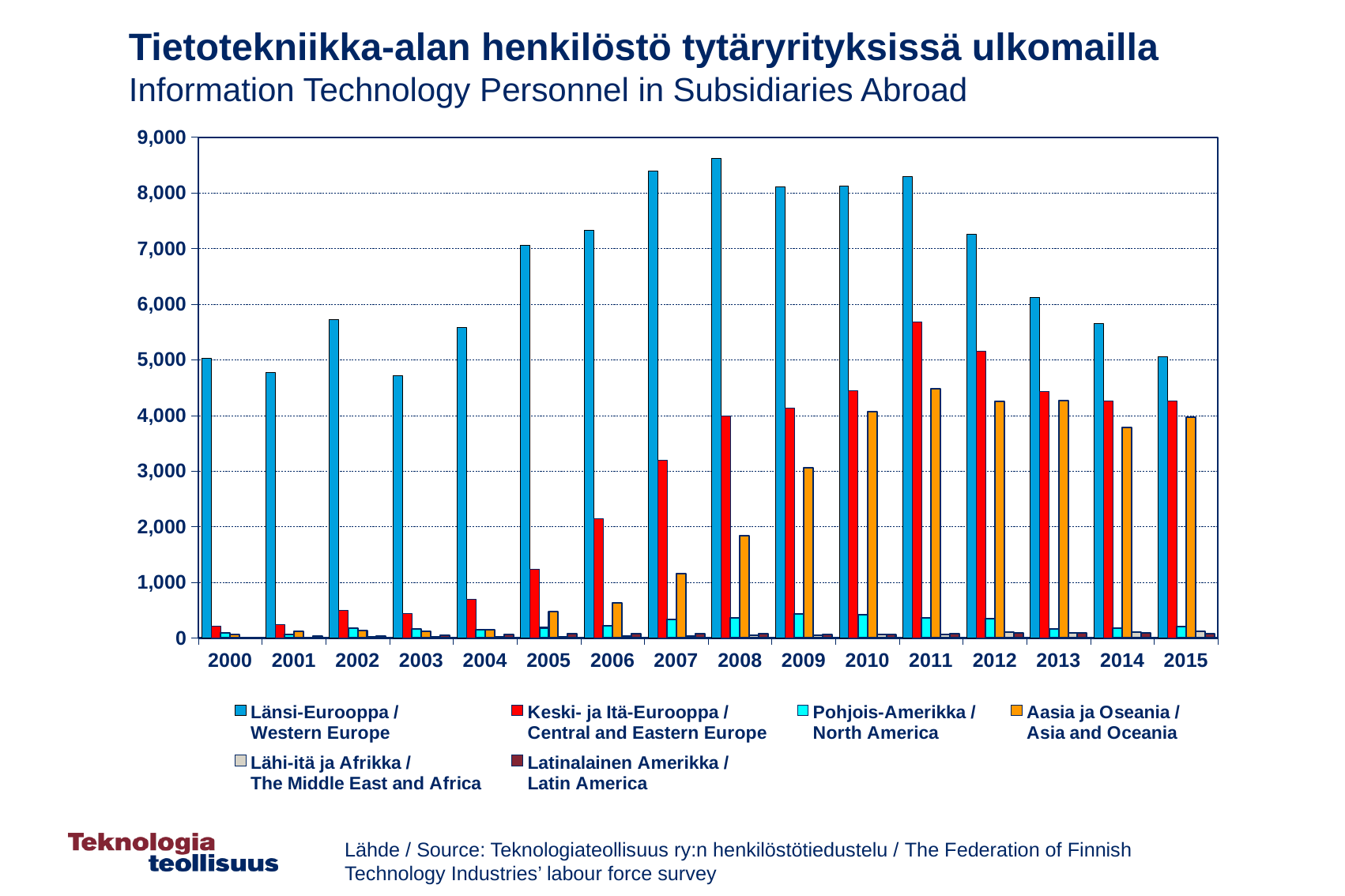
Is the value for Asia and Oceania in 2008 greater or less than 2,000? less What kind of chart is shown on the slide? bar chart Which colour represents Asia and Oceania in the chart? orange Is the value for Central and Eastern Europe in 2007 greater or less than 3,000? greater Is the value for Western Europe in 2008 greater or less than 8,000? greater In which year is the value for Central and Eastern Europe highest? 2011 How many series does the legend list? 6 How many years are shown on the x axis? 16 In 2009, which is larger: the value for Central and Eastern Europe or the value for Asia and Oceania? Central and Eastern Europe In which year is the value for Western Europe highest? 2008 In which year is the value for Asia and Oceania highest? 2011 Does the value for Western Europe rise or fall from 2011 to 2015? fall